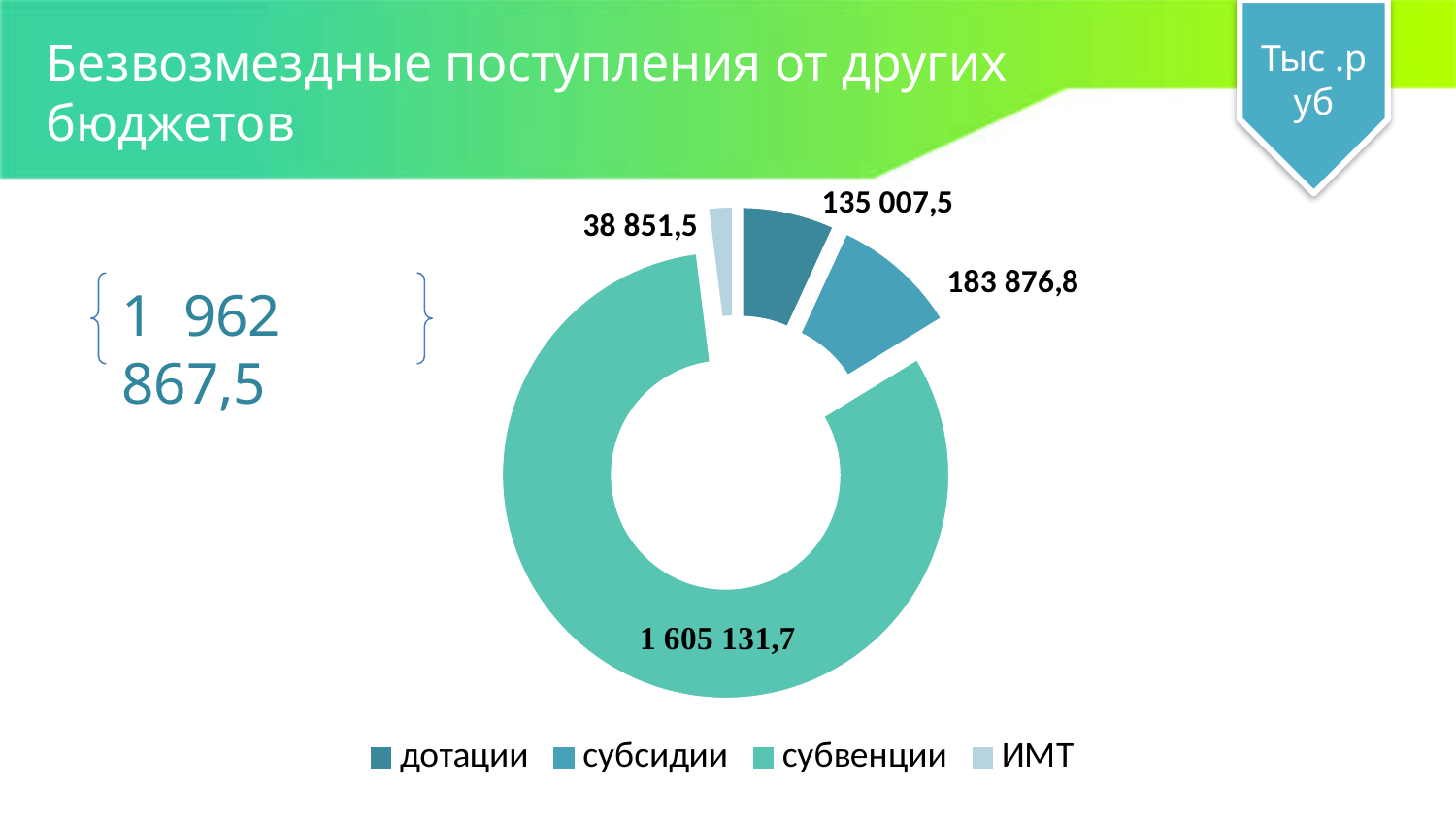
Which category has the largest value? субвенции What type of chart is shown on the slide? doughnut (pie) chart What unit is indicated in the badge at the top right of the slide? Тыс. руб What is the value for субвенции? 1 605 131,7 What is the difference between субсидии and дотации? 48 869,3 How many categories does the chart show? 4 Which is larger, субсидии or дотации? субсидии What is the value for ИМТ? 38 851,5 What is the value for субсидии? 183 876,8 Which category has the smallest value? ИМТ What is the value for дотации? 135 007,5 What total is shown on the slide for all categories combined? 1 962 867,5